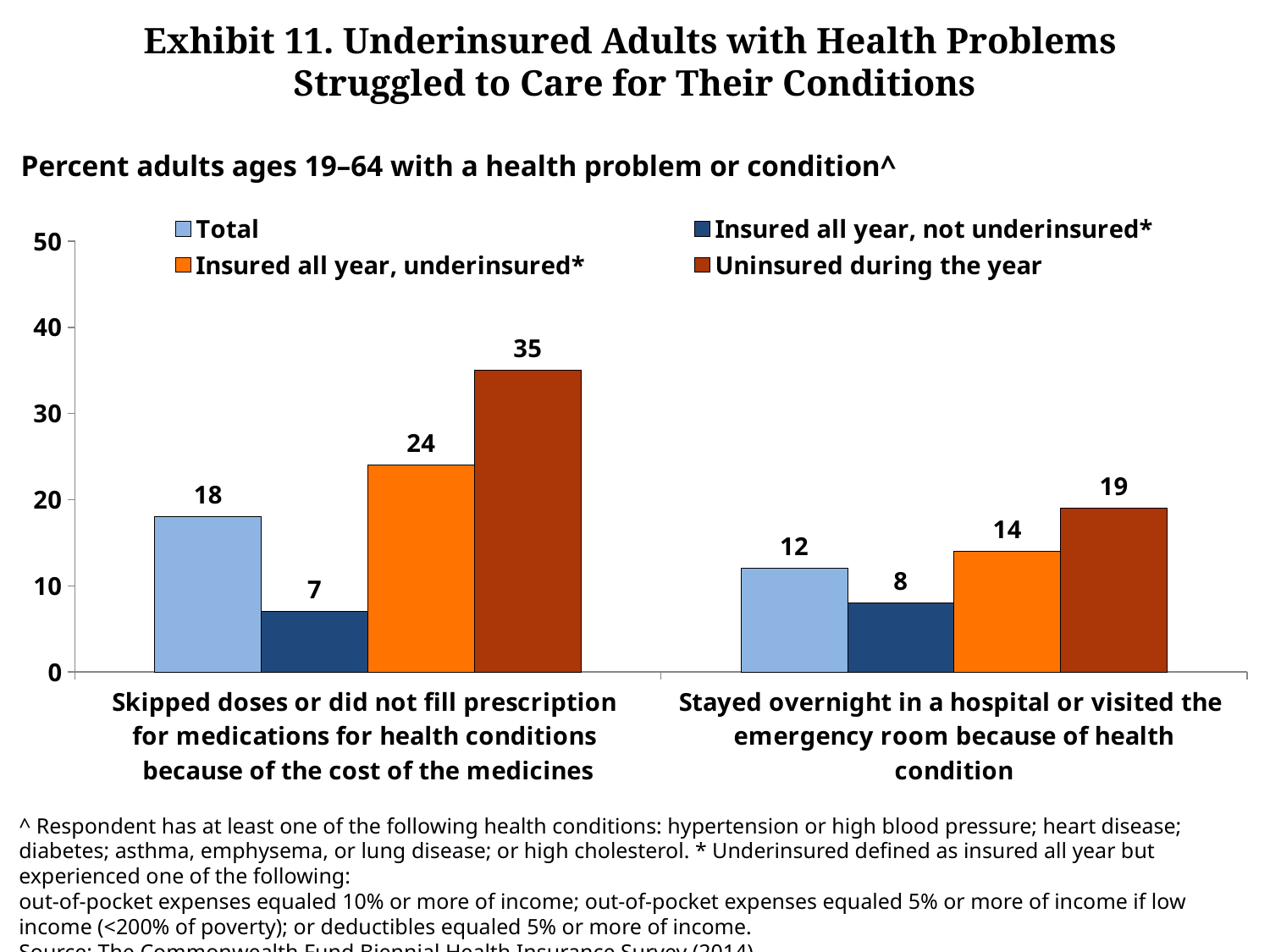
How many categories are shown on the x axis? 2 What is the value for "Uninsured during the year" in the "Skipped doses or did not fill prescription" category? 35 Which series has the highest value in the "Stayed overnight in a hospital or visited the emergency room" category? Uninsured during the year What is the value for "Total" in the "Stayed overnight in a hospital or visited the emergency room" category? 12 How many series does the legend list? 4 What is the difference between the "Uninsured during the year" and "Insured all year, underinsured*" values in the "Skipped doses or did not fill prescription" category? 11 Is the value for "Uninsured during the year" in the "Skipped doses or did not fill prescription" category greater or less than 30? greater What kind of chart is shown on the slide? bar chart What colour are the bars for the "Insured all year, underinsured*" series? orange What is the value for "Insured all year, not underinsured*" in the "Skipped doses or did not fill prescription" category? 7 Which is larger: the "Insured all year, underinsured*" value for "Skipped doses or did not fill prescription" or for "Stayed overnight in a hospital or visited the emergency room"? Skipped doses or did not fill prescription Which series has the lowest value in the "Skipped doses or did not fill prescription" category? Insured all year, not underinsured*